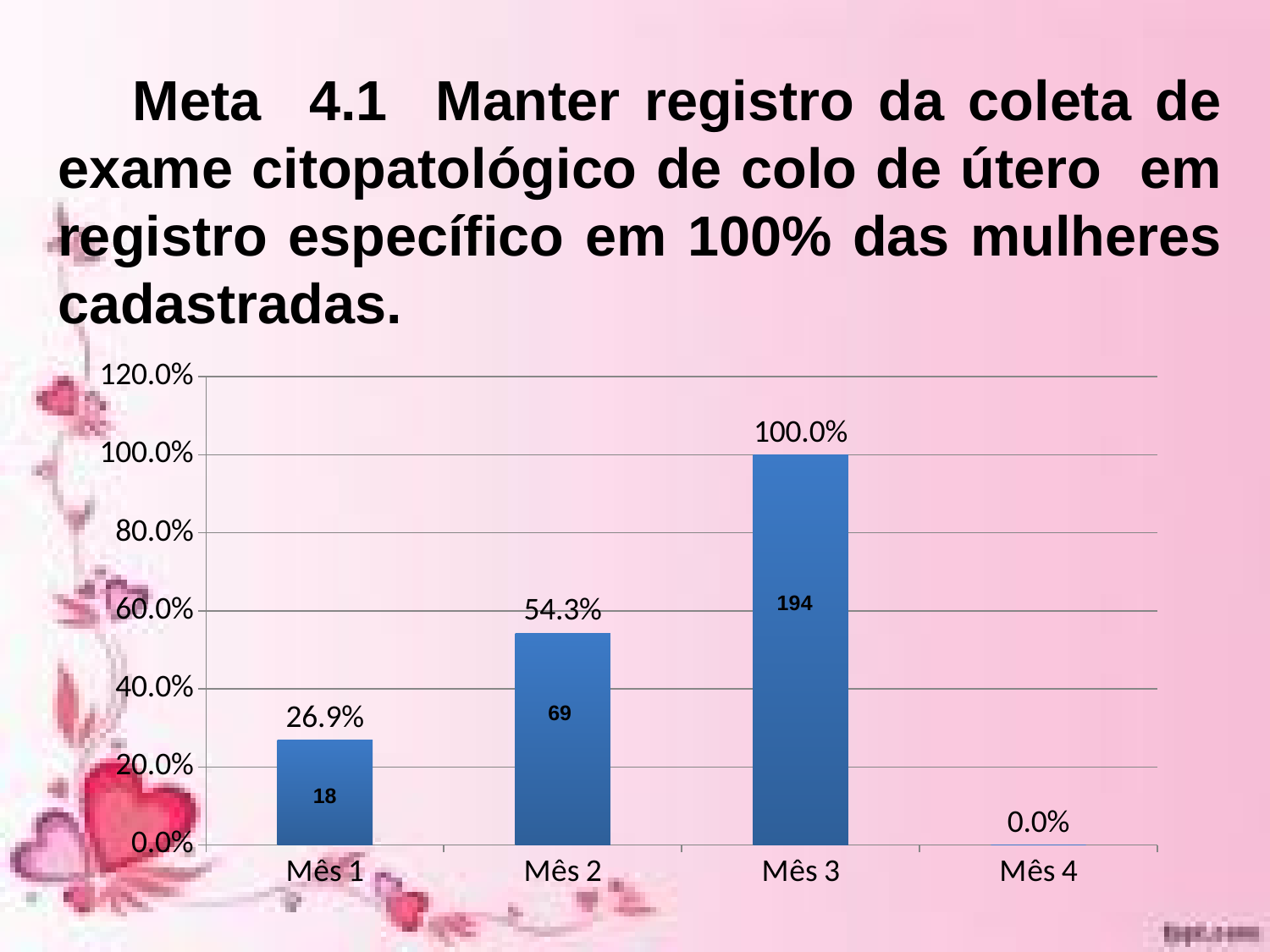
Which month has the lowest percentage value? Mês 4 How many months (categories) are shown on the x axis? 4 What is the percentage value shown for Mês 2? 54.3% What is the highest value shown on the y axis? 120.0% What is the percentage value shown for Mês 4? 0.0% What number is printed inside the bar for Mês 3? 194 What number is printed inside the bar for Mês 1? 18 Which month has the highest percentage value? Mês 3 Which has a larger percentage value, Mês 1 or Mês 2? Mês 2 What is the percentage value shown for Mês 1? 26.9% What kind of chart is shown on the slide? Bar chart What is the difference in percentage points between Mês 3 and Mês 2? 45.7